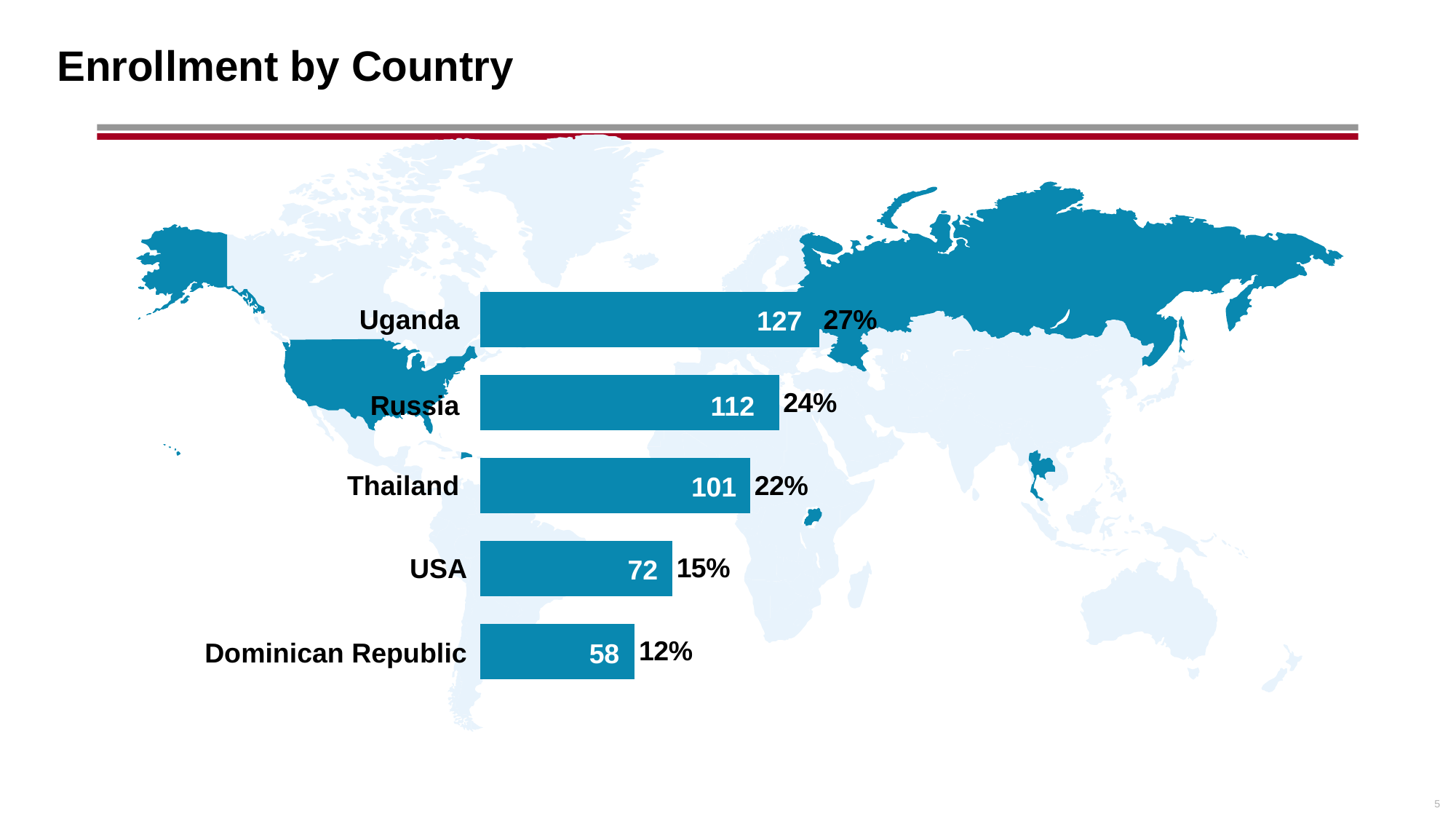
What percentage share is shown for Russia? 24% What percentage share is shown for the Dominican Republic? 12% What is the title of the slide? Enrollment by Country What is the difference in enrollment between USA and the Dominican Republic? 14 How many countries are shown in the chart? 5 What is the difference in enrollment between Uganda and Russia? 15 What kind of chart is shown on the slide? Bar chart What is the enrollment value for Uganda? 127 Which country has the highest enrollment? Uganda Which country has the lowest enrollment? Dominican Republic What is the enrollment value for Thailand? 101 Which has a larger enrollment, Thailand or USA? Thailand